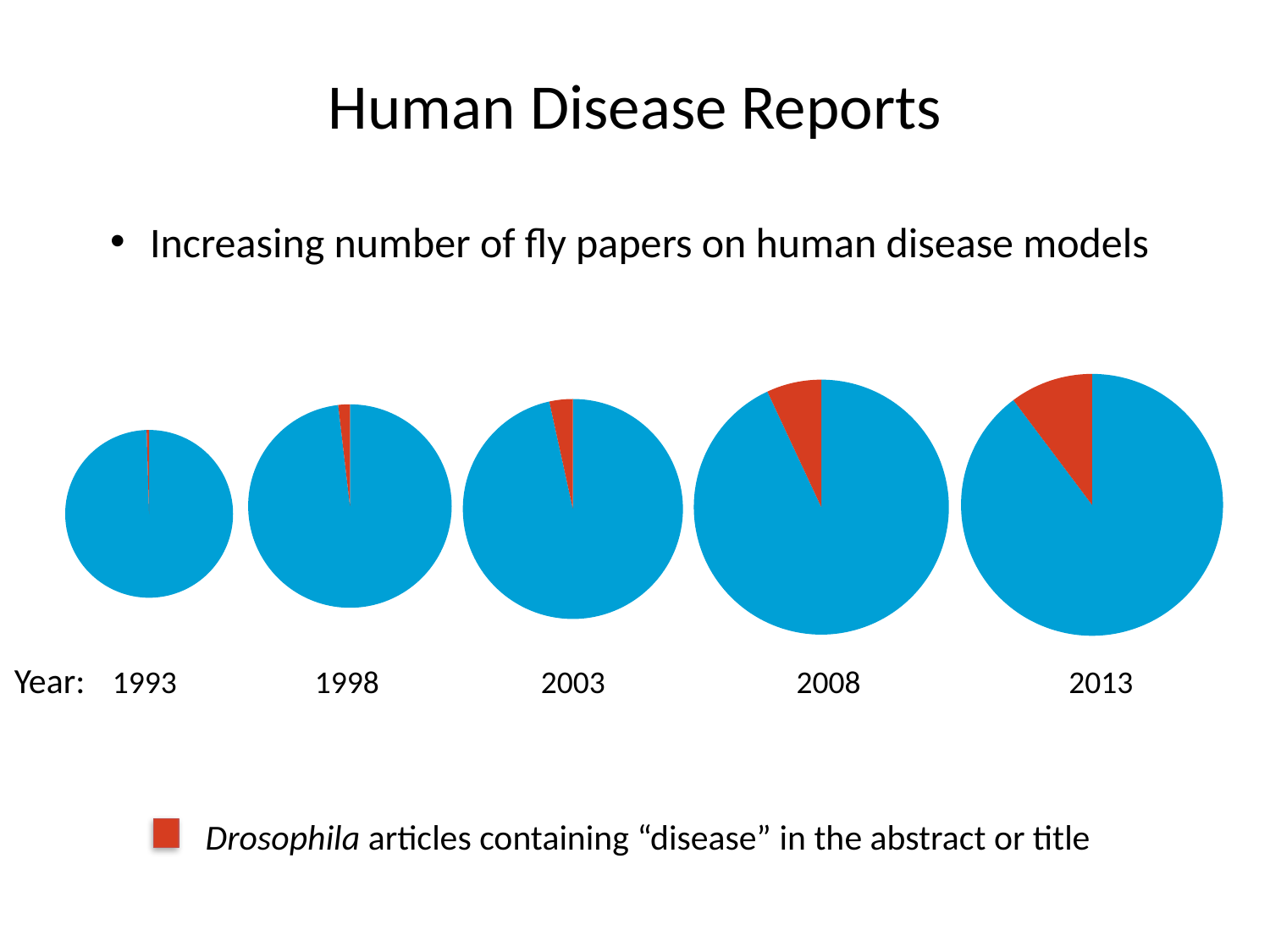
Is the red slice in the 2013 pie chart greater or less than half of the pie? less Which year's pie chart has the smallest red slice? 1993 Does the overall size of the pie charts increase or decrease from 1993 to 2013? Increase How many pie charts are shown on the slide? 5 Is the red slice larger in the 2008 pie chart or the 2003 pie chart? 2008 What does the red slice in the pie charts represent, according to the legend? Drosophila articles containing "disease" in the abstract or title Which years are labelled under the pie charts? 1993, 1998, 2003, 2008, 2013 Which year's pie chart has the largest red slice? 2013 What kind of chart is used on the slide to show the Human Disease Reports data? Pie chart Does the share of the red slice rise or fall from 1993 to 2013? Rise Is the red slice larger in the 1998 pie chart or the 2013 pie chart? 2013